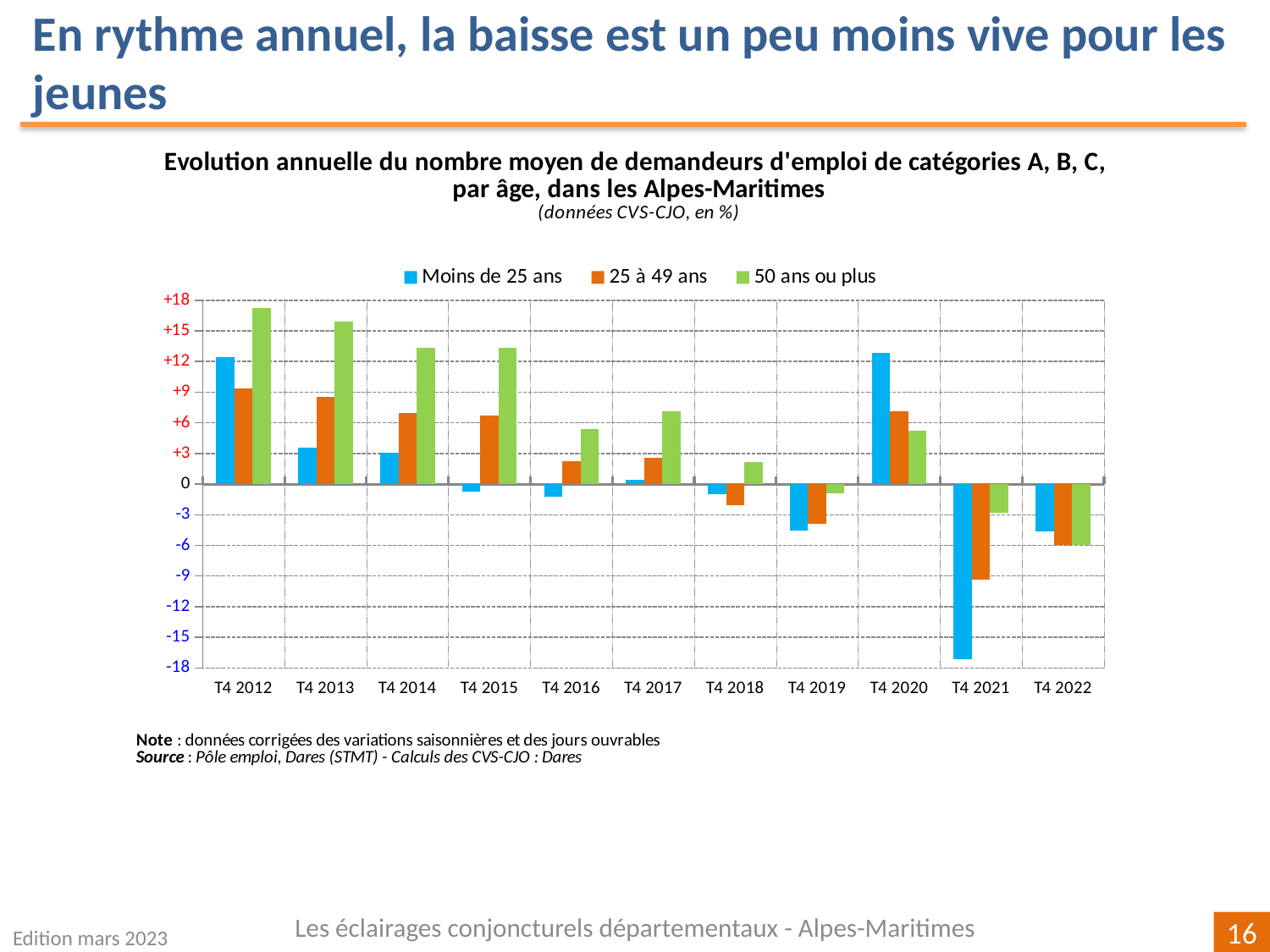
How many series does the legend list? 3 In T4 2020, which is larger: the value for 'Moins de 25 ans' or for '50 ans ou plus'? Moins de 25 ans Is the value for '50 ans ou plus' in T4 2012 greater or less than 15? greater What kind of chart is shown on the slide? bar chart What colour represents the series 'Moins de 25 ans' in the legend? blue In T4 2013, which series has the highest value? 50 ans ou plus How many quarters (categories) are shown on the x axis? 11 For the series '50 ans ou plus', which quarter has the highest value? T4 2012 Is the value for 'Moins de 25 ans' in T4 2021 greater or less than -15? less Is the value for '25 à 49 ans' in T4 2021 greater or less than -6? less In T4 2021, which is larger: the value for '25 à 49 ans' or for '50 ans ou plus'? 50 ans ou plus For the series 'Moins de 25 ans', which quarter has the lowest value? T4 2021